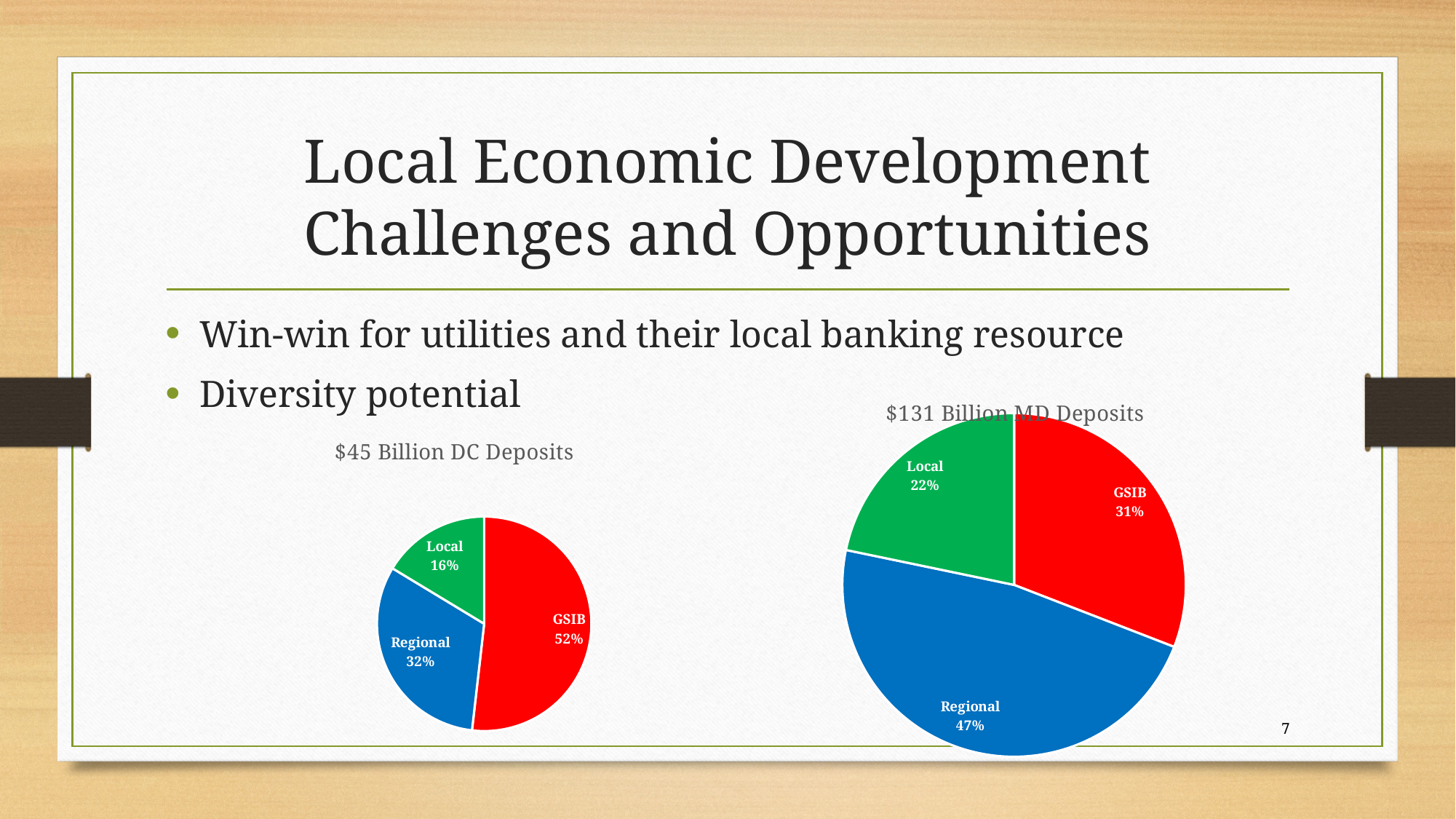
What kind of chart is the "$131 Billion MD Deposits" chart? Pie chart How many categories does the "$45 Billion DC Deposits" chart show? 3 In the "$131 Billion MD Deposits" chart, which category has the smallest slice? Local In the "$45 Billion DC Deposits" chart, what colour is the Regional slice? Blue In the "$45 Billion DC Deposits" chart, what share does Local hold? 16% In the "$45 Billion DC Deposits" chart, what share does GSIB hold? 52% In the "$45 Billion DC Deposits" chart, what is the difference in percentage points between GSIB and Regional? 20 In the "$131 Billion MD Deposits" chart, what share does Regional hold? 47% In the "$131 Billion MD Deposits" chart, what share does GSIB hold? 31% In the "$131 Billion MD Deposits" chart, which is larger, the GSIB slice or the Local slice? GSIB In the "$45 Billion DC Deposits" chart, which category has the largest slice? GSIB In the "$131 Billion MD Deposits" chart, which category has the largest slice? Regional